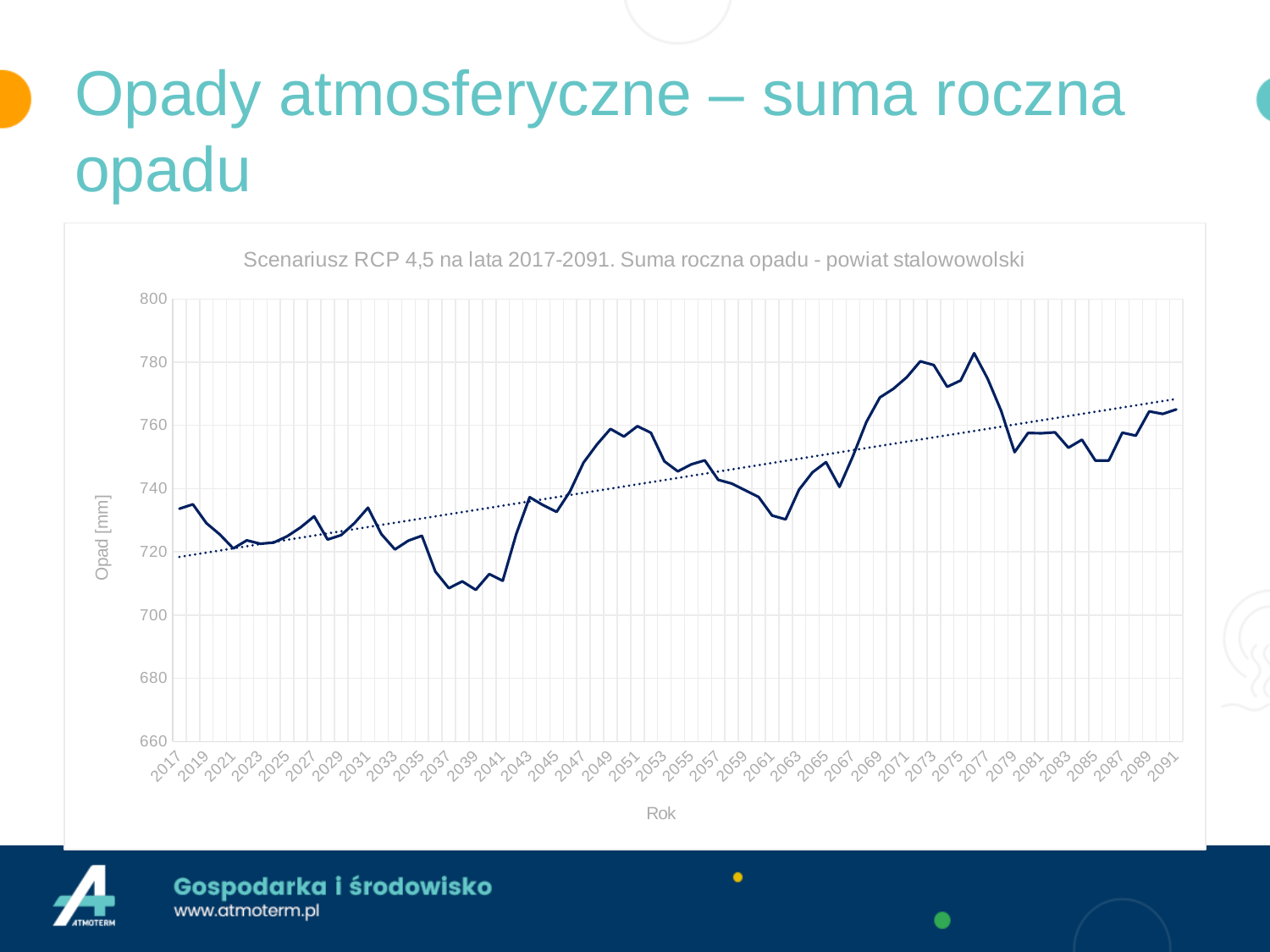
What is the label of the vertical axis? Opad [mm] In which year does the line reach its highest value? 2076 Is the value for 2077 greater or less than 760? greater What kind of chart is shown on the slide? line chart Overall, do the values rise or fall from 2017 to 2091 along the x axis? rise Is the value for 2038 greater or less than 720? less What is the title of the chart? Scenariusz RCP 4,5 na lata 2017-2091. Suma roczna opadu - powiat stalowowolski Is the value for 2073 greater or less than 760? greater Which year has the larger value, 2077 or 2038? 2077 Which year has the larger value, 2017 or 2073? 2073